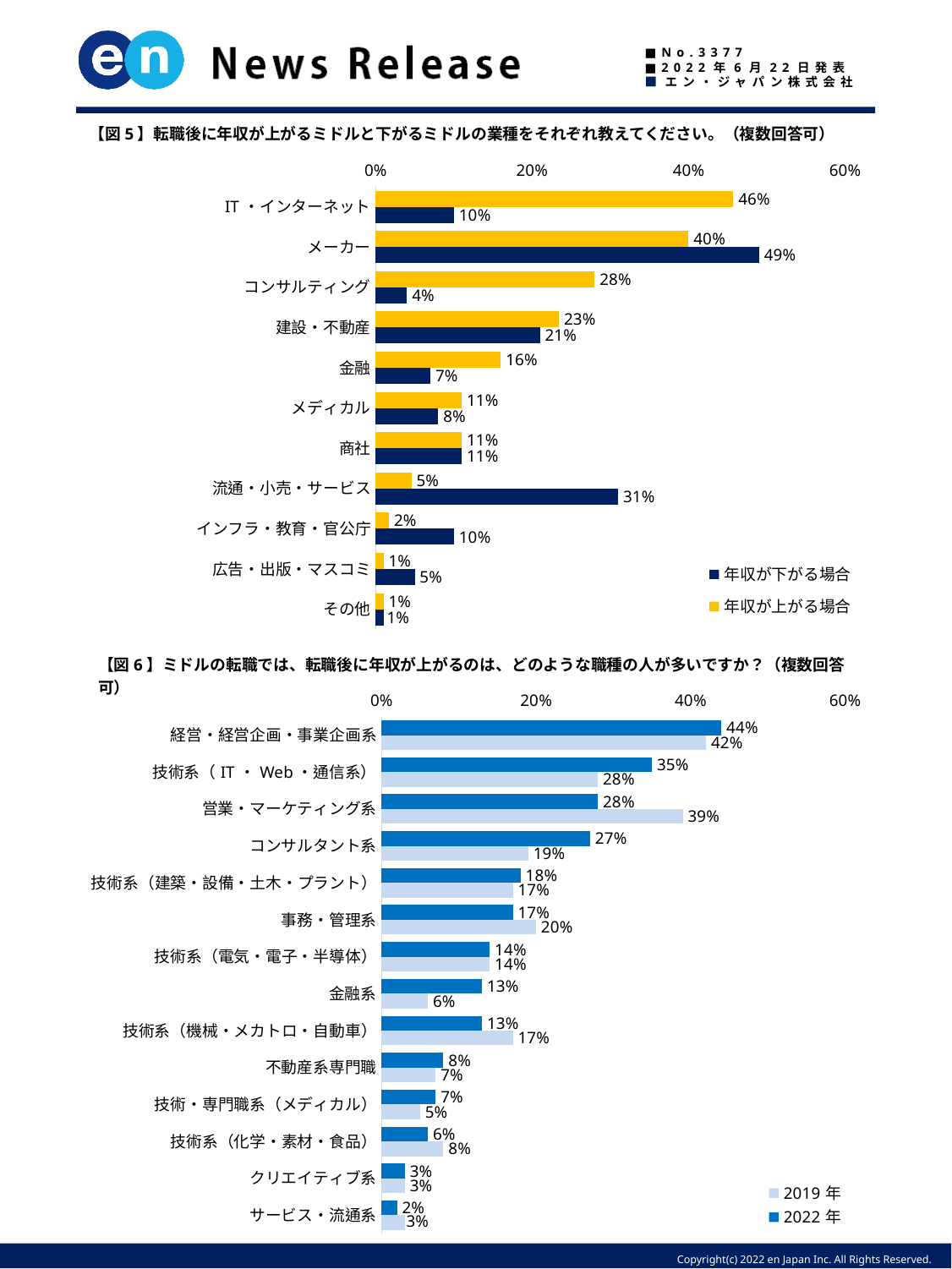
In the bottom chart (図6), what is the difference between the 2019年 and 2022年 values for 金融系? 7% In the top chart (図5), how many categories are shown? 11 In the top chart (図5), which category has the highest value in the 年収が下がる場合 series? メーカー In the bottom chart (図6), what is the 2019年 value for 事務・管理系? 20% What type of chart is the bottom chart (図6)? Bar chart In the bottom chart (図6), what is the 2022年 value for 営業・マーケティング系? 28% In the bottom chart (図6), which category has the highest 2022年 value? 経営・経営企画・事業企画系 In the top chart (図5), what is the value for 流通・小売・サービス in the 年収が下がる場合 series? 31% In the top chart (図5), what is the difference between the 年収が上がる場合 and 年収が下がる場合 values for コンサルティング? 24% In the bottom chart (図6), how many series does the legend list? 2 In the top chart (図5), what is the value for IT・インターネット in the 年収が上がる場合 series? 46% In the top chart (図5), which series has the larger value for メーカー, 年収が上がる場合 or 年収が下がる場合? 年収が下がる場合